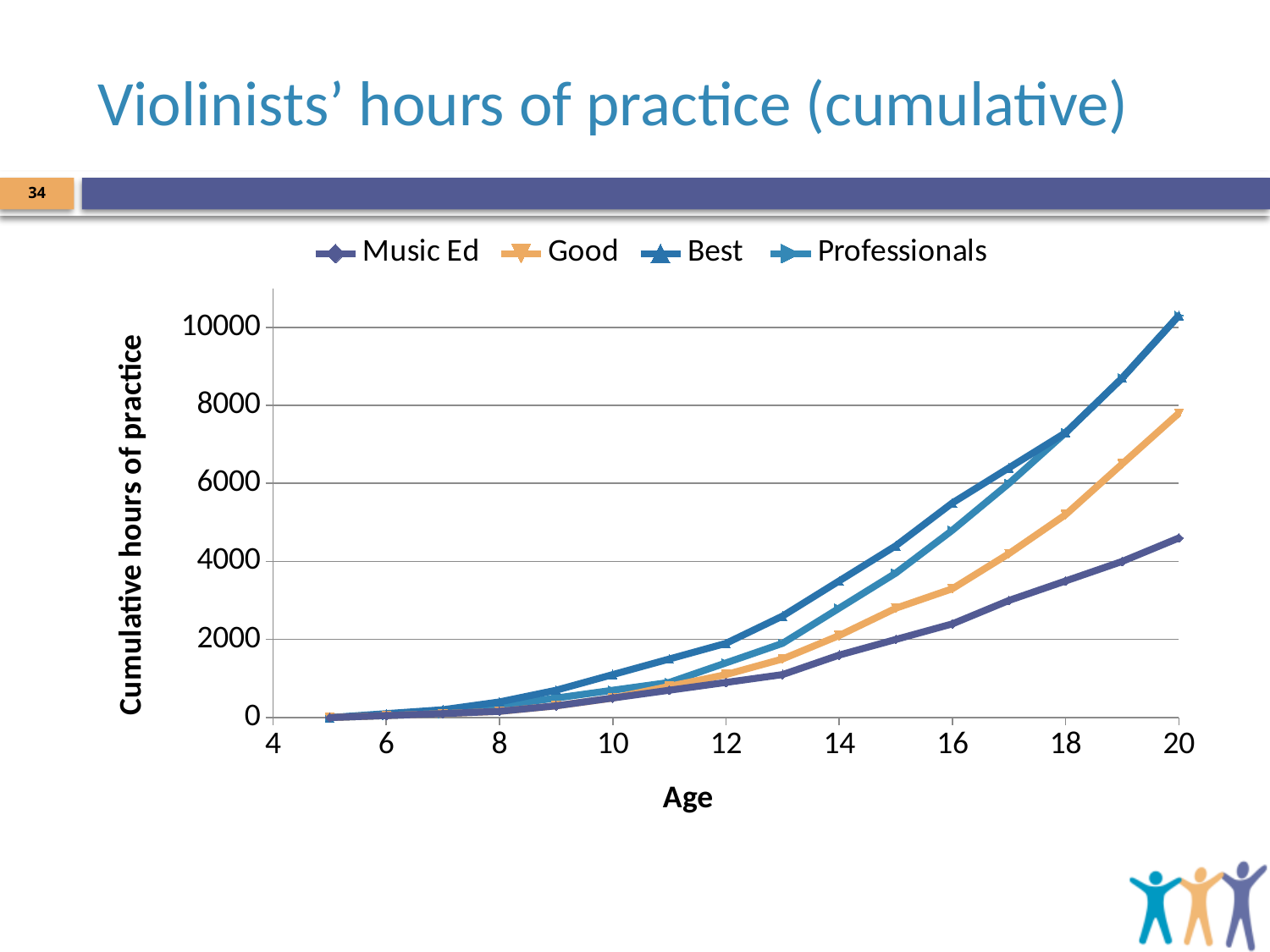
Which series has the lowest cumulative hours at age 20? Music Ed At age 20, which is larger: Good or Music Ed? Good At age 16, which is larger: Best or Good? Best Is the value for Good at age 20 greater or less than 6000? greater What is the title of the chart? Violinists' hours of practice (cumulative) Do the cumulative hours for the Best series rise or fall as age increases? rise What is the label on the vertical axis? Cumulative hours of practice Is the value for Professionals at age 12 greater or less than 4000? less How many series does the legend list? 4 What kind of chart is shown on the slide? line chart Is the value for Best at age 16 greater or less than 4000? greater